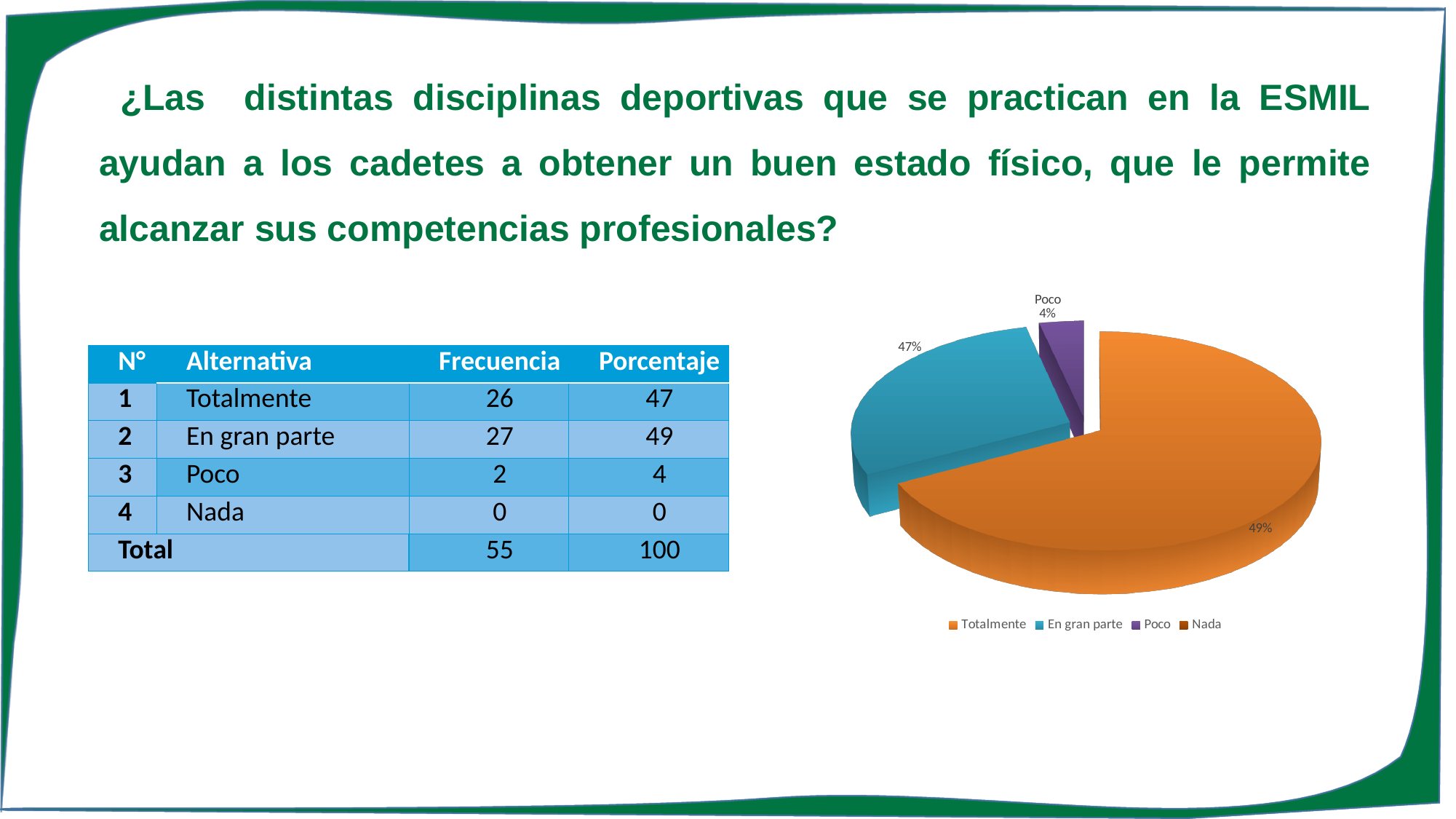
What percentage label is printed on the orange slice of the pie chart? 49% What kind of chart is shown on the slide? pie chart Which legend entry of the pie chart is shown in orange? Totalmente Is the Poco slice of the pie chart larger or smaller than the orange slice? smaller What is the difference between the 49% slice and the 47% slice in the pie chart? 2% What percentage label is printed on the teal slice of the pie chart? 47% Which legend entry of the pie chart is shown in purple? Poco How many slices are visible in the pie chart? 3 How many entries does the pie chart's legend list? 4 Which category in the pie chart has the smallest visible slice? Poco What is the difference between the 47% slice and the Poco slice in the pie chart? 43% What percentage is shown for the Poco slice in the pie chart? 4%